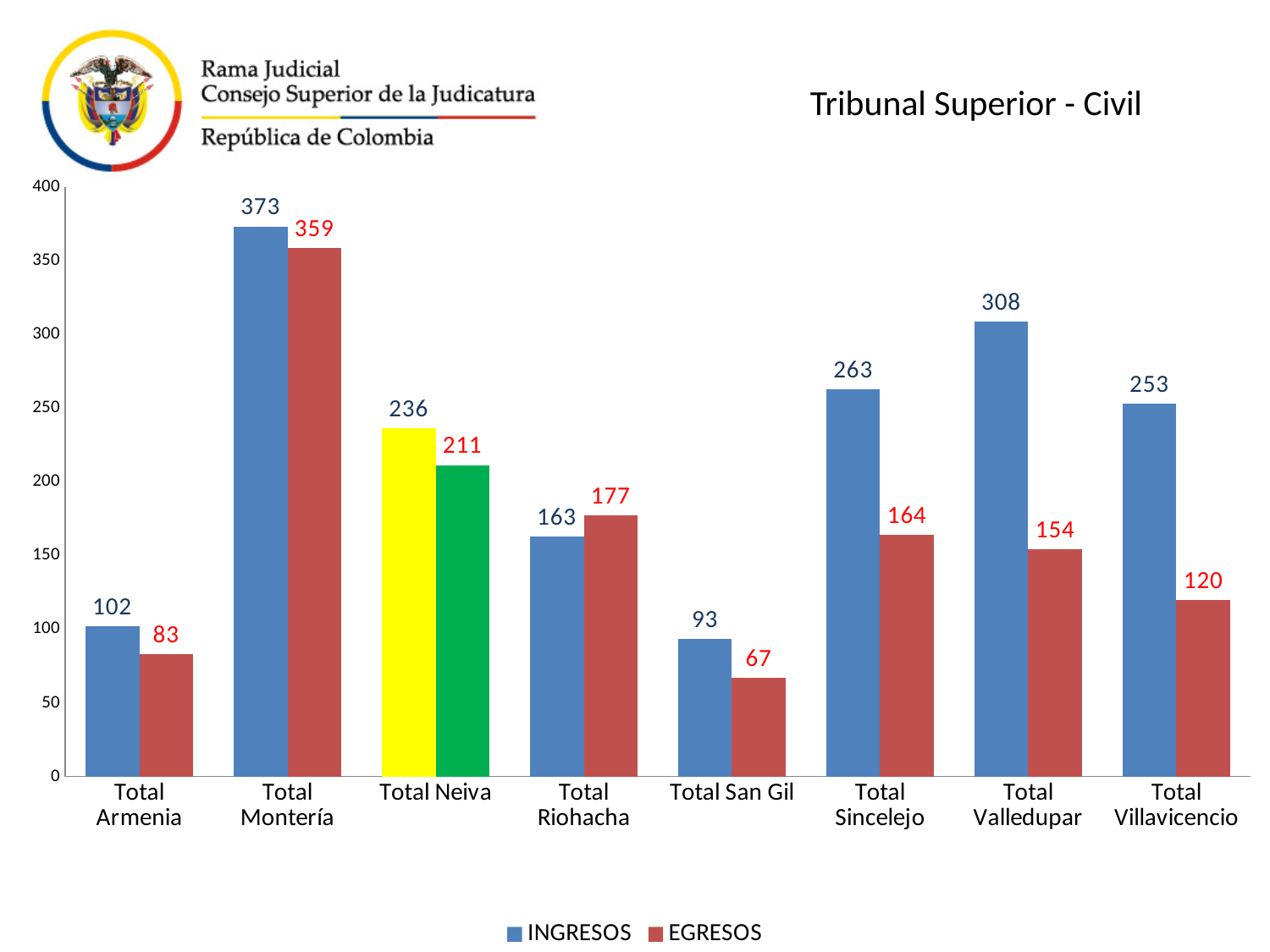
What is the EGRESOS value for Total Neiva? 211 Which is larger for Total Riohacha, INGRESOS or EGRESOS? EGRESOS What is the difference between the INGRESOS values for Total Sincelejo and Total Armenia? 161 How many series does the legend list? 2 What is the INGRESOS value for Total Montería? 373 How many categories are shown on the x axis? 8 What kind of chart is shown on the slide? Bar chart Which category has the lowest EGRESOS value? Total San Gil What is the difference between INGRESOS and EGRESOS for Total Valledupar? 154 Which category has the highest INGRESOS value? Total Montería What is the EGRESOS value for Total Villavicencio? 120 What is the title of the chart? Tribunal Superior - Civil